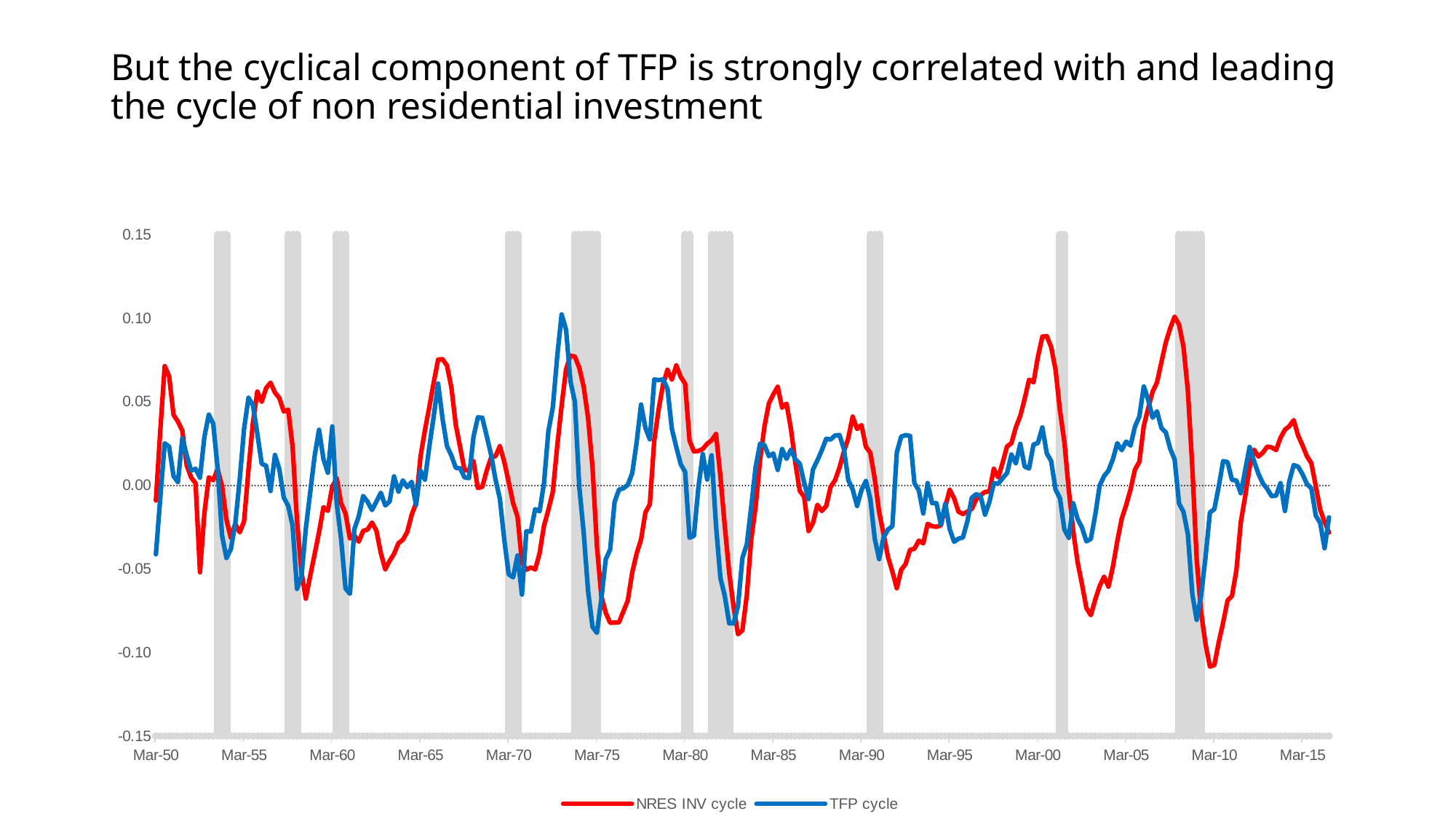
What kind of chart is shown on the slide? line chart Is the lowest point of the TFP cycle line near Mar-75 greater or less than -0.05? less What are the two series named in the legend? NRES INV cycle and TFP cycle What is the first label on the horizontal axis? Mar-50 How many labels are shown on the horizontal axis? 14 What colour is the TFP cycle line? blue What is the highest value shown on the vertical axis? 0.15 How many series does the legend list? 2 Is the peak of the NRES INV cycle line near Mar-00 greater or less than 0.05? greater What is the lowest value shown on the vertical axis? -0.15 What is the last label on the horizontal axis? Mar-15 Which series reaches the lowest value anywhere on the chart, NRES INV cycle or TFP cycle? NRES INV cycle